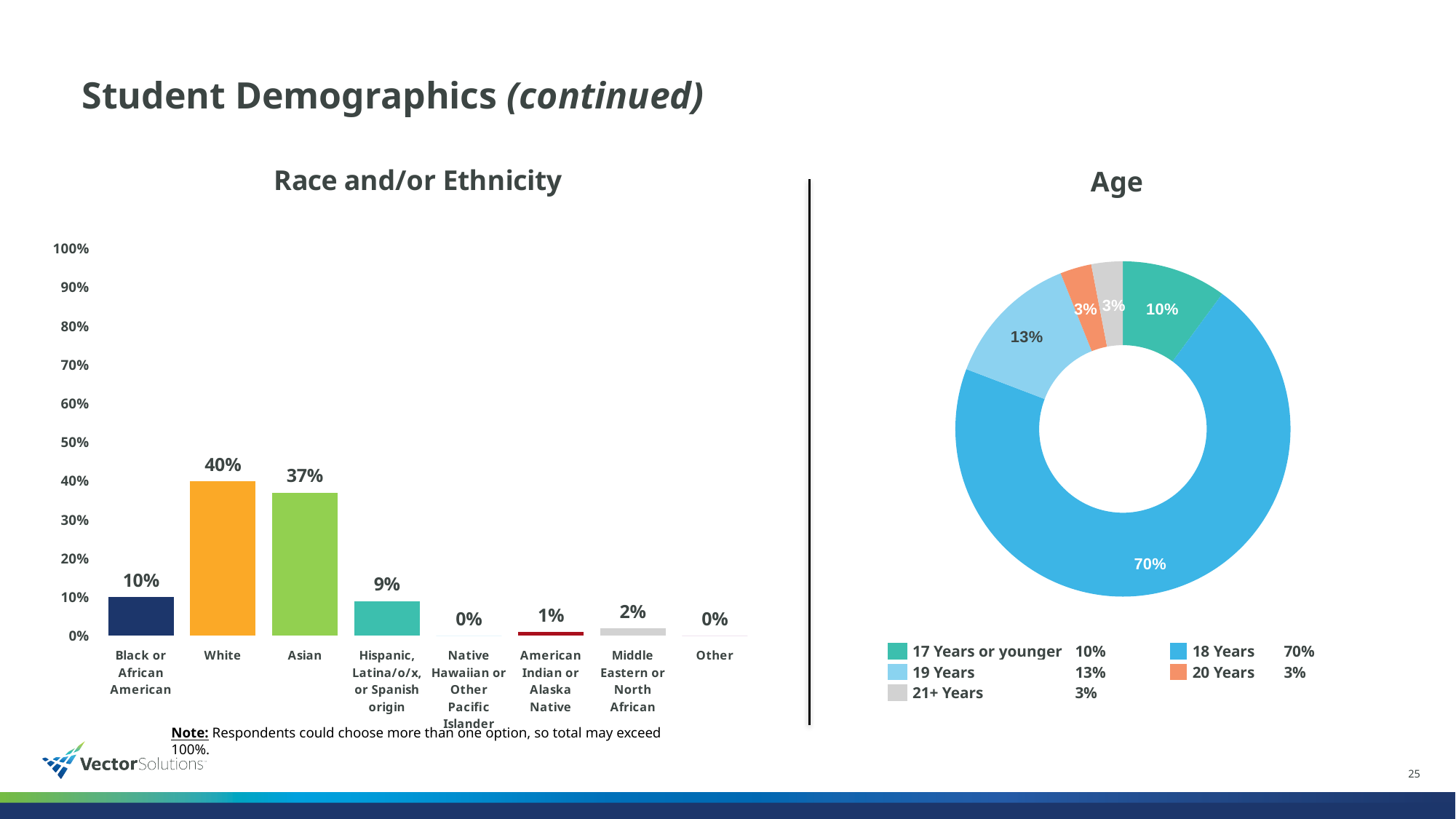
In the Race and/or Ethnicity chart, what is the value for White? 40% In the Age chart, which age group has the largest share? 18 Years In the Age chart, what share of respondents are 18 Years? 70% In the Race and/or Ethnicity chart, what is the difference between the values for White and Asian? 3% What kind of chart is the Age chart? Doughnut chart In the Race and/or Ethnicity chart, what is the value for Hispanic, Latina/o/x, or Spanish origin? 9% How many categories are shown in the Race and/or Ethnicity chart? 8 In the Race and/or Ethnicity chart, which category has the highest value? White What kind of chart is the Race and/or Ethnicity chart? Bar chart How many entries does the legend of the Age chart list? 5 In the Age chart, what is the value for 19 Years? 13% In the Race and/or Ethnicity chart, which is larger: Black or African American or Middle Eastern or North African? Black or African American